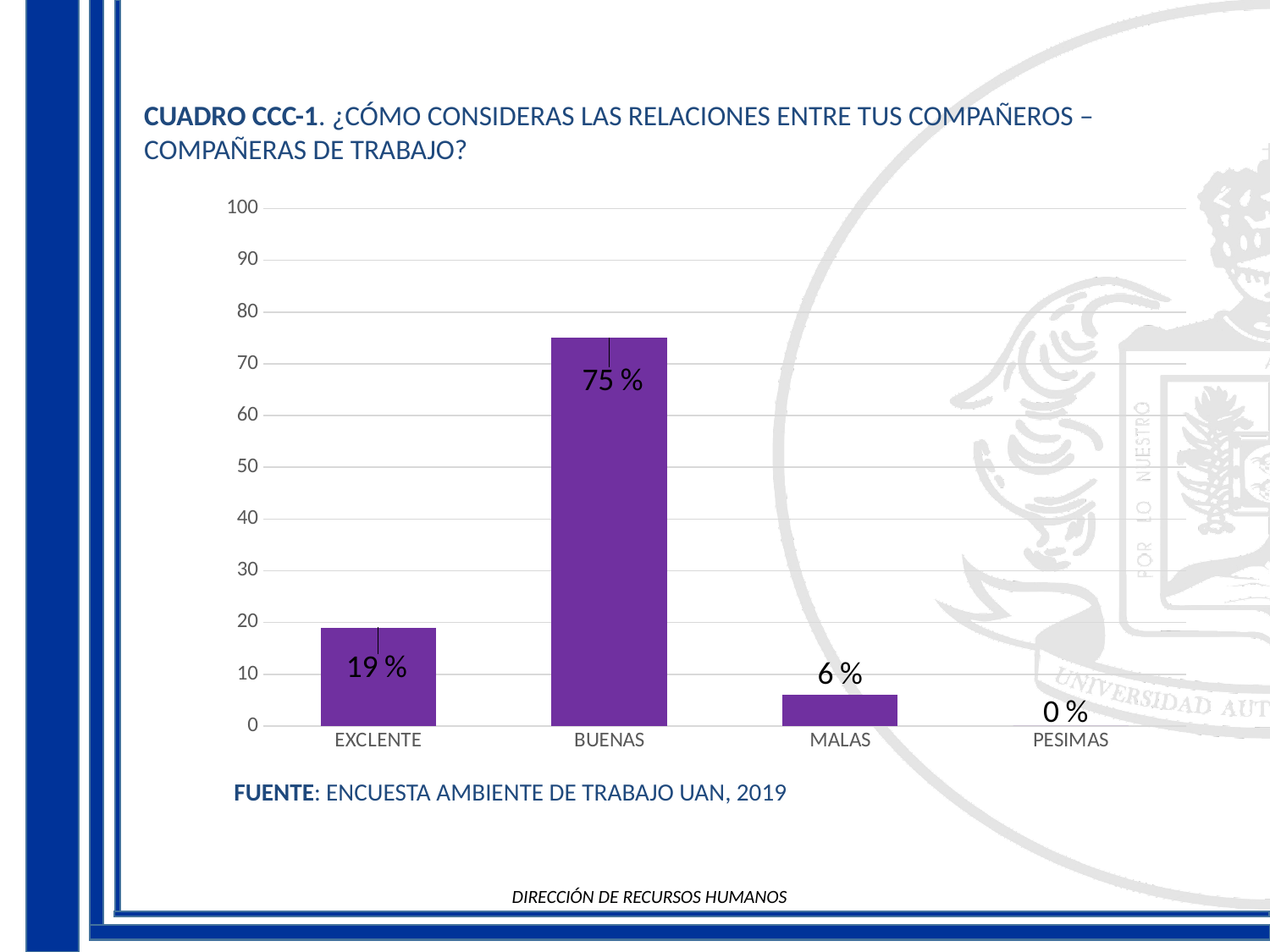
Which category has the highest value? BUENAS What is the value for MALAS? 6 % Which is larger, the value for EXCLENTE or the value for MALAS? EXCLENTE What is the value for BUENAS? 75 % What source is cited below the chart? ENCUESTA AMBIENTE DE TRABAJO UAN, 2019 What is the difference between the values for BUENAS and EXCLENTE? 56 % Is the value for BUENAS greater or less than 70? greater What is the value for PESIMAS? 0 % What is the value for EXCLENTE? 19 % Which category has the lowest value? PESIMAS What kind of chart is shown on the slide? bar chart How many categories are shown on the x axis? 4